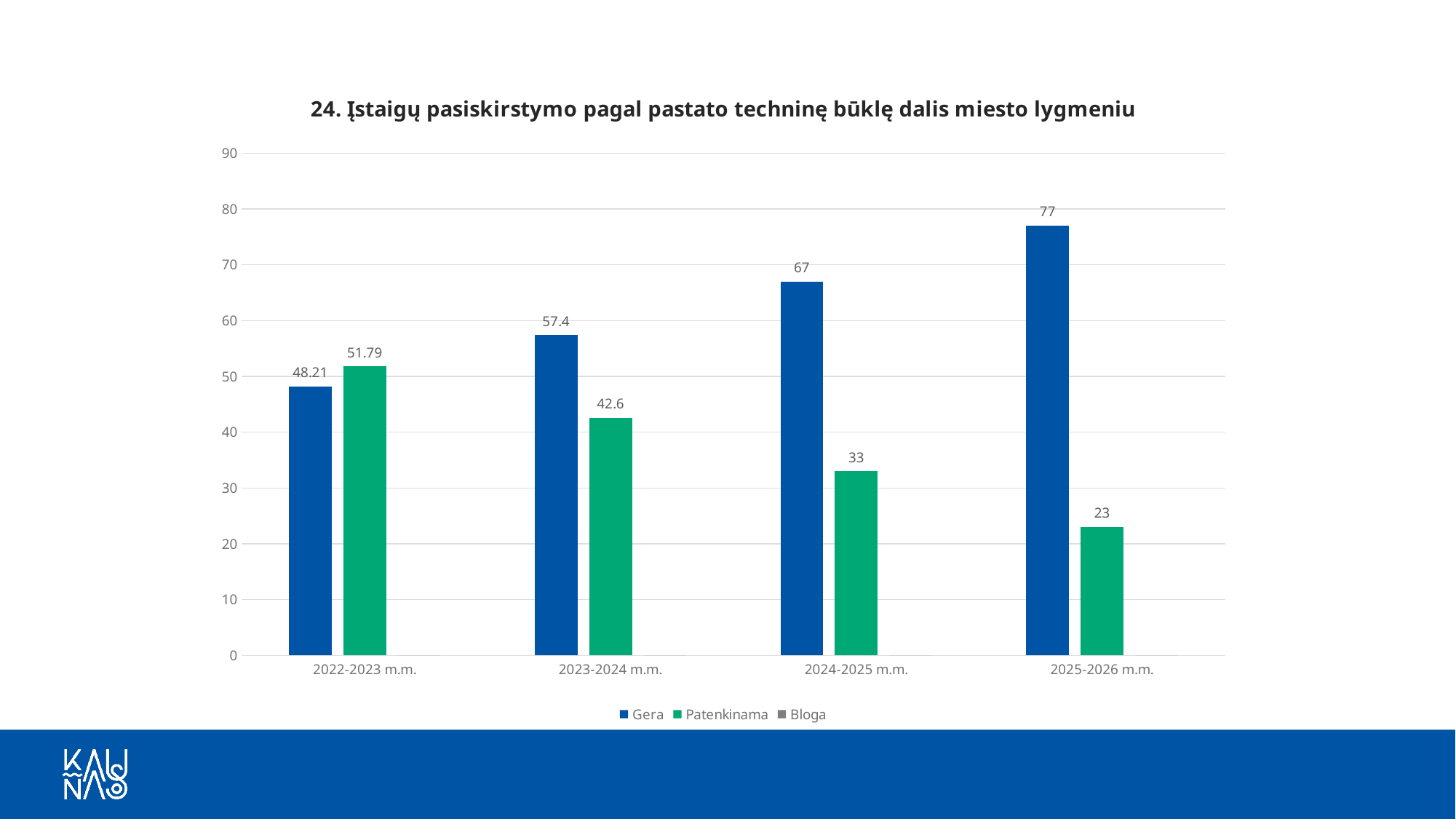
How many school years are shown on the x axis? 4 What is the value for Gera in 2022-2023 m.m.? 48.21 What is the value for Patenkinama in 2025-2026 m.m.? 23 In which school year is the Gera value highest? 2025-2026 m.m. What is the difference between the Gera and Patenkinama values in 2023-2024 m.m.? 14.8 Is the value for Gera in 2025-2026 m.m. greater or less than 70? greater How many series does the legend list? 3 Which is larger in 2022-2023 m.m., Gera or Patenkinama? Patenkinama In which school year is the Patenkinama value lowest? 2025-2026 m.m. What kind of chart is shown on the slide? Bar chart Does the Patenkinama value rise or fall from 2022-2023 m.m. to 2025-2026 m.m.? Fall What is the value for Gera in 2024-2025 m.m.? 67